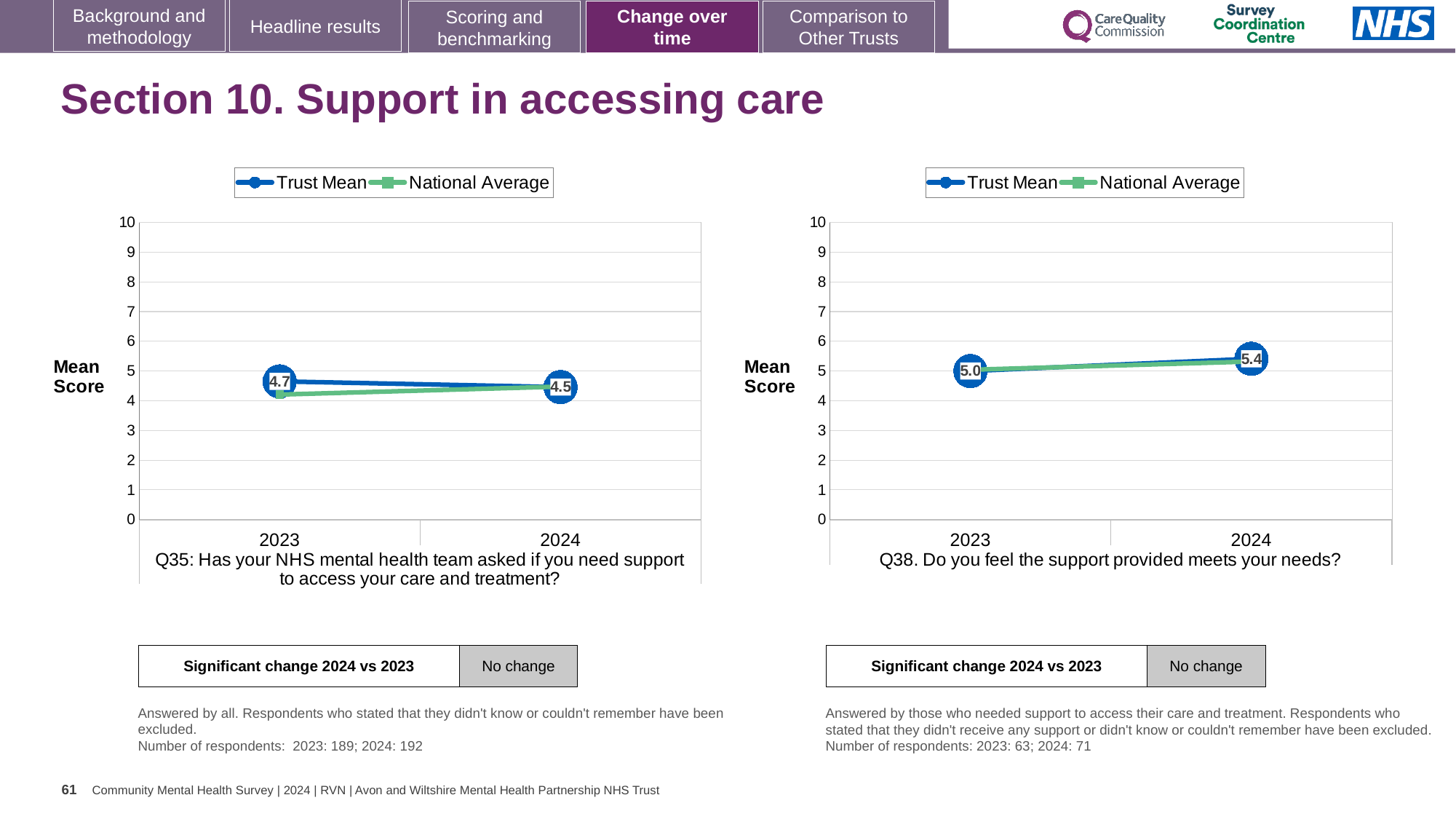
In the Q35 chart on the left, by how much did the Trust Mean change from 2023 to 2024? 0.2 In the Q38 chart on the right, what is the Trust Mean score for 2023? 5.0 In the Q35 chart on the left, what is the Trust Mean score for 2023? 4.7 In the Q38 chart on the right, what is the Trust Mean score for 2024? 5.4 What kind of chart is the Q35 chart on the left? line chart How many series does the legend of the Q38 chart on the right list? 2 In the Q35 chart on the left, does the Trust Mean rise or fall from 2023 to 2024? fall In the Q38 chart on the right, does the Trust Mean rise or fall from 2023 to 2024? rise In the Q35 chart on the left, what is the Trust Mean score for 2024? 4.5 In the Q35 chart on the left, is the National Average value for 2023 greater or less than 5? less In the Q38 chart on the right, what is the difference between the Trust Mean for 2024 and 2023? 0.4 In the Q35 chart on the left, which is larger, the Trust Mean for 2023 or the Trust Mean for 2024? 2023